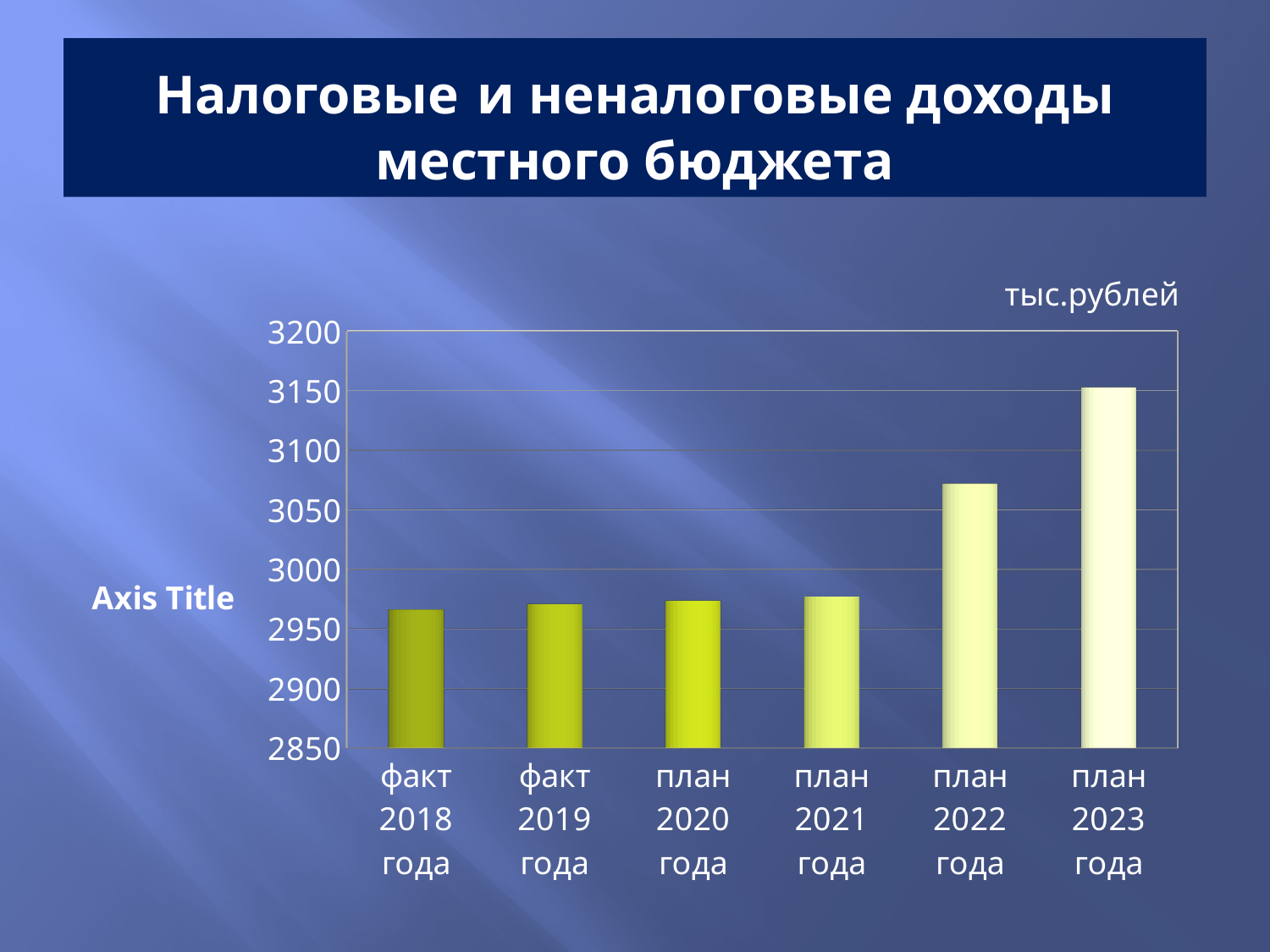
How many categories (bars) does the chart show? 6 Is the value for план 2022 года greater or less than 3050? greater Which is larger, the value for план 2022 года or the value for план 2021 года? план 2022 года Which is larger, the value for факт 2019 года or the value for план 2023 года? план 2023 года What kind of chart is shown on the slide? bar chart Is the value for факт 2018 года greater or less than 3000? less Is the value for план 2021 года greater or less than 2950? greater What unit is indicated above the chart? тыс.рублей What is the title of the slide? Налоговые и неналоговые доходы местного бюджета Do the values rise or fall from факт 2018 года to план 2023 года? rise Which category has the highest value? план 2023 года